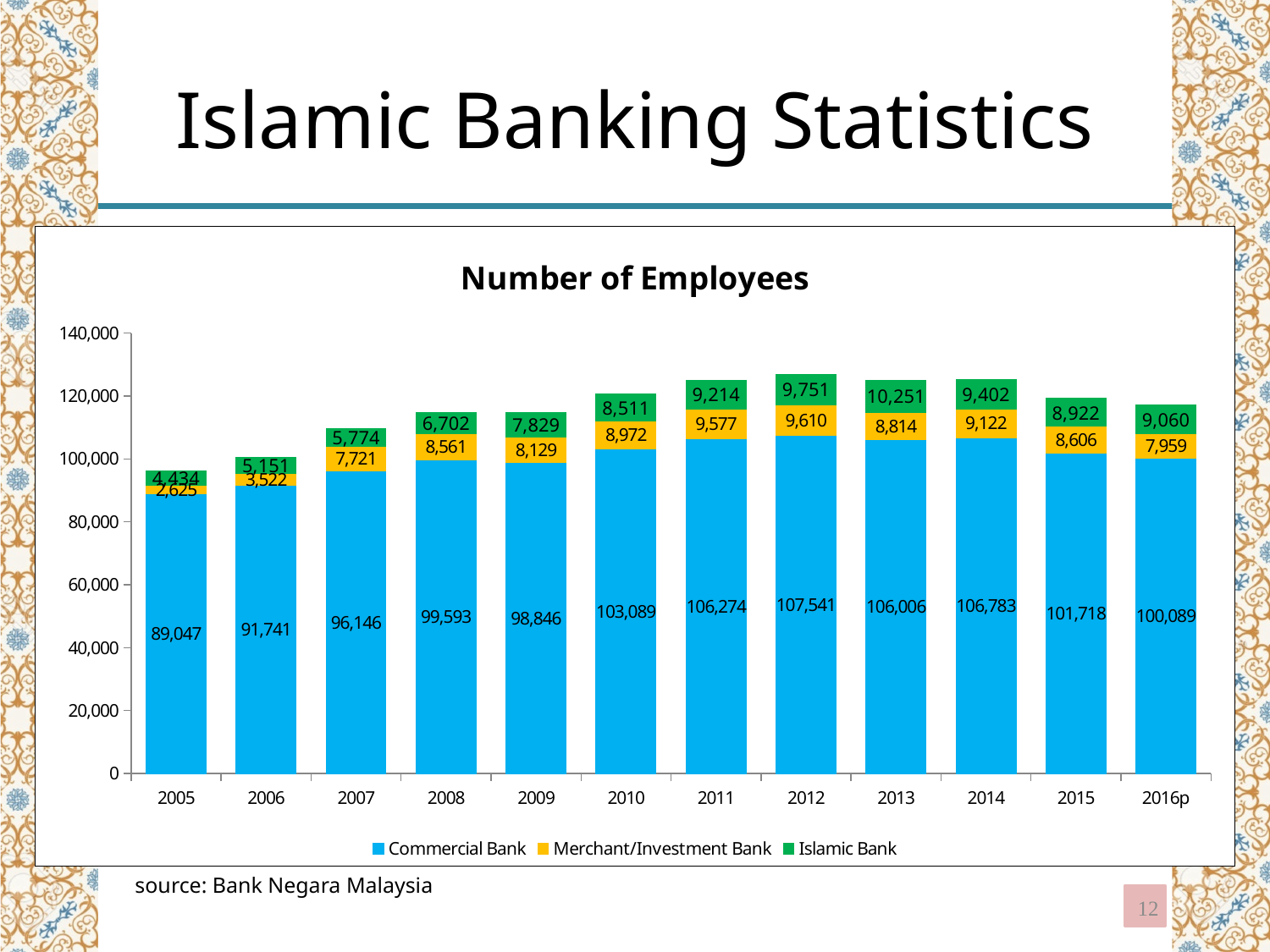
Is the total height of the 2012 stacked bar greater or less than 120,000? greater What is the Commercial Bank value for 2010? 103,089 How many series does the legend list? 3 Which year has the lowest Islamic Bank value? 2005 Which is larger, the Islamic Bank value for 2013 or for 2012? 2013 How many years are shown on the x axis? 12 What is the Merchant/Investment Bank value for 2008? 8,561 What is the Islamic Bank value for 2013? 10,251 What is the difference between the Commercial Bank values for 2012 and 2005? 18,494 What is the total of the stacked bar for 2012? 126,902 Which year has the highest Commercial Bank value? 2012 What kind of chart is shown? Stacked bar chart